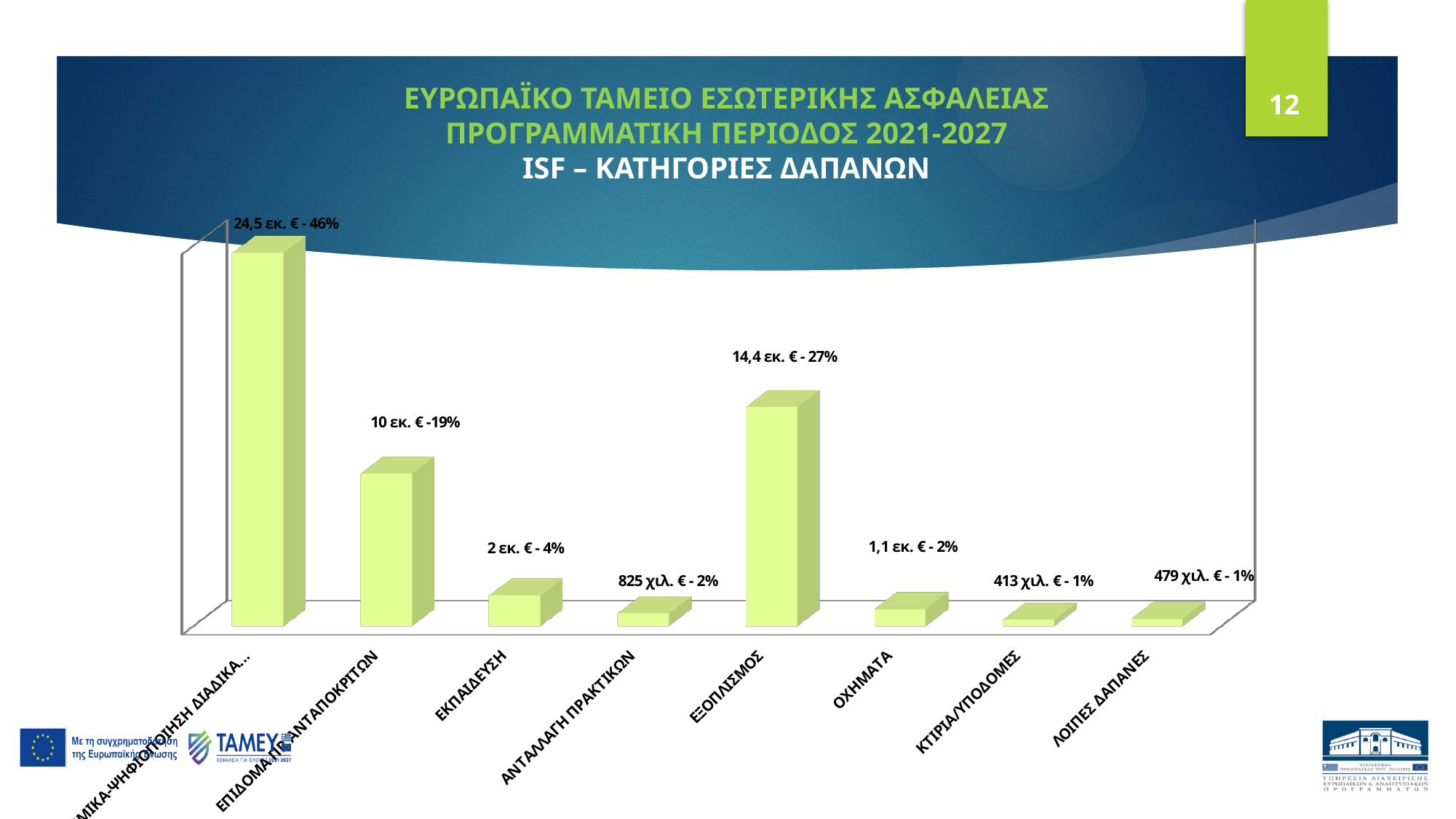
What value is shown for ΕΞΟΠΛΙΣΜΟΣ? 14,4 εκ. € - 27% Which is larger, ΕΞΟΠΛΙΣΜΟΣ or ΕΚΠΑΙΔΕΥΣΗ? ΕΞΟΠΛΙΣΜΟΣ What is the percentage share shown for ΚΤΙΡΙΑ/ΥΠΟΔΟΜΕΣ? 1% What value is shown for ΛΟΙΠΕΣ ΔΑΠΑΝΕΣ? 479 χιλ. € - 1% What value is shown for ΟΧΗΜΑΤΑ? 1,1 εκ. € - 2% How many categories are shown in the chart? 8 Which category has the lowest value? ΚΤΙΡΙΑ/ΥΠΟΔΟΜΕΣ What value is shown for ΑΝΤΑΛΛΑΓΗ ΠΡΑΚΤΙΚΩΝ? 825 χιλ. € - 2% What value is shown for ΕΚΠΑΙΔΕΥΣΗ? 2 εκ. € - 4% Which is larger, ΛΟΙΠΕΣ ΔΑΠΑΝΕΣ or ΚΤΙΡΙΑ/ΥΠΟΔΟΜΕΣ? ΛΟΙΠΕΣ ΔΑΠΑΝΕΣ What kind of chart is shown on the slide? Bar chart What is the difference in percentage share between ΕΞΟΠΛΙΣΜΟΣ and ΕΚΠΑΙΔΕΥΣΗ? 23 percentage points